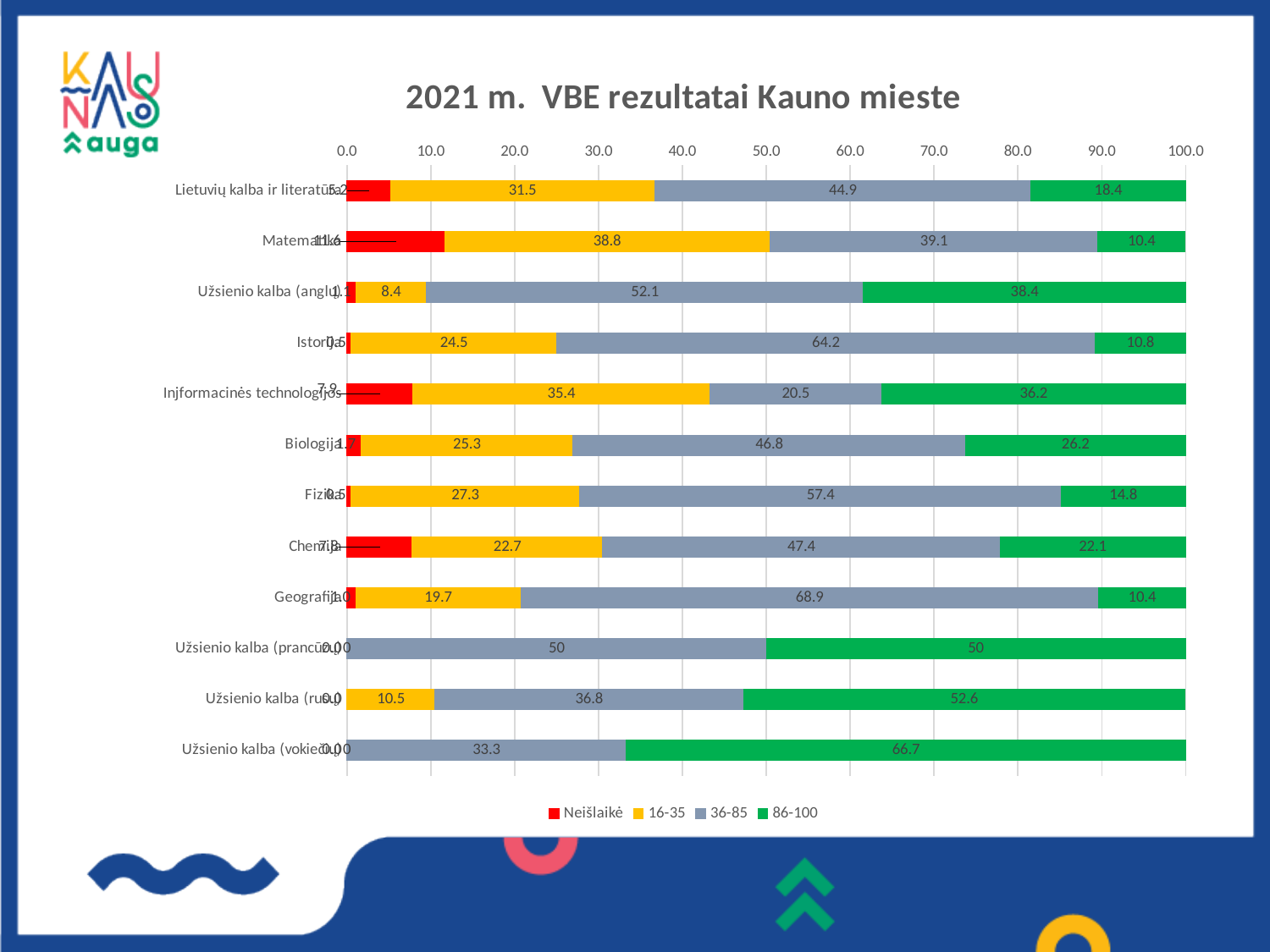
Which subject has the highest value in the 36-85 series? Geografija What is the value of the 36-85 series for Istorija? 64.2 What is the title of the chart? 2021 m. VBE rezultatai Kauno mieste What is the difference between the 36-85 values for Fizika and Chemija? 10.0 What kind of chart is shown on the slide? stacked bar chart Which is larger: the 86-100 value for Biologija or for Chemija? Biologija What is the value of the 86-100 series for Užsienio kalba (anglų)? 38.4 What is the value of the 36-85 series for Užsienio kalba (rusų)? 36.8 How many subject categories are shown on the chart? 12 Which subject has the highest value in the 86-100 series? Užsienio kalba (vokiečių) How many series does the legend list? 4 What is the value of the 16-35 series for Matematika? 38.8